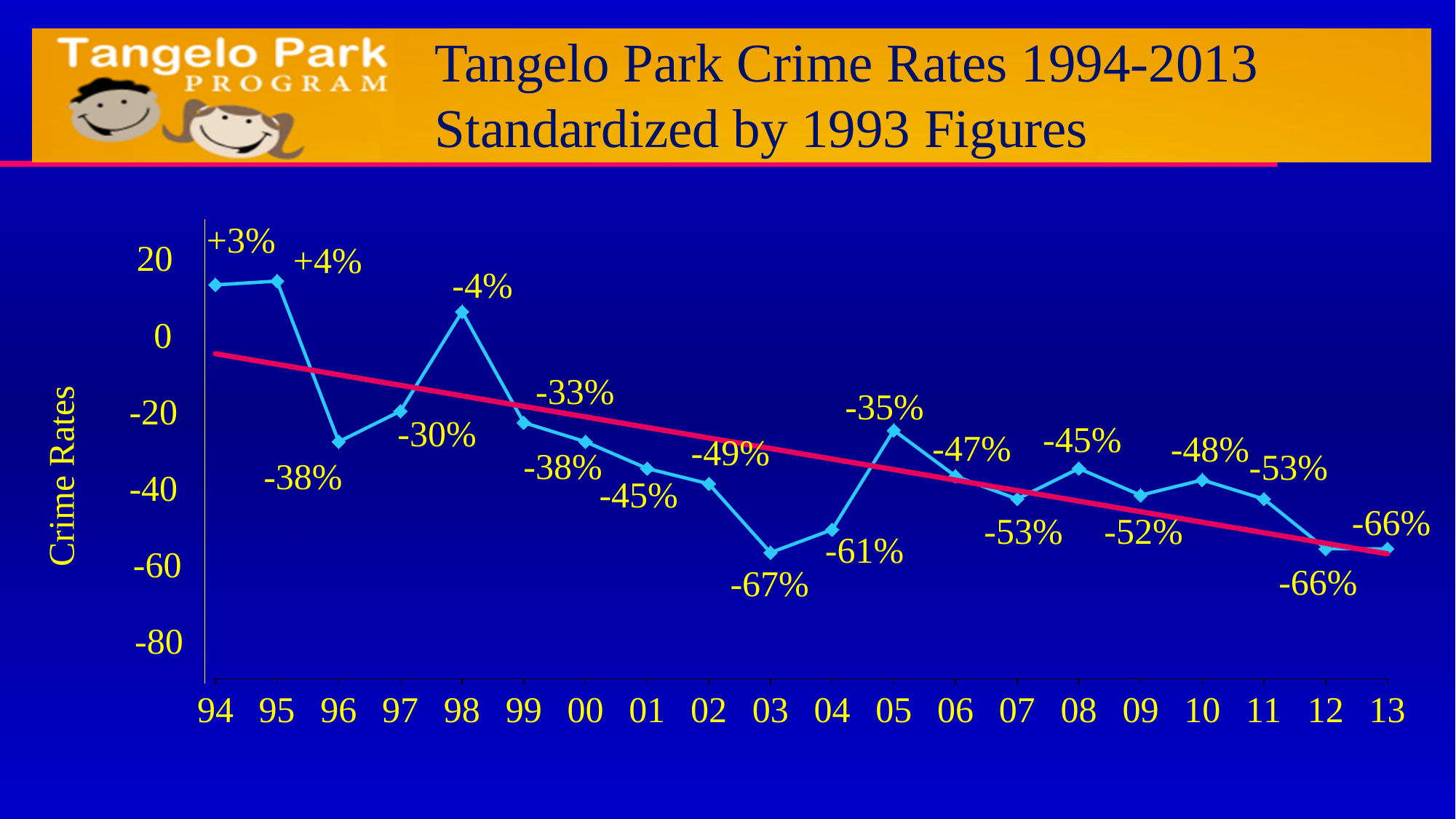
How many years (data points) are plotted on the x axis? 20 Which year has the highest labelled crime rate value? 95 What is the crime rate value labelled for 1994 (94)? +3% What is the title of the chart on the slide? Tangelo Park Crime Rates 1994-2013 Standardized by 1993 Figures What is the crime rate value labelled for 2005 (05)? -35% Which is larger, the labelled value for 1998 (98) or for 1999 (99)? 98 Do the crime rate values generally rise or fall from 1994 to 2013? fall What kind of chart is shown on the slide? line chart Which year has the lowest labelled crime rate value? 03 What is the crime rate value labelled for 2013 (13)? -66% What is the crime rate value labelled for 2003 (03)? -67% What is the difference in percentage points between the labelled values for 2005 (05) and 2003 (03)? 32